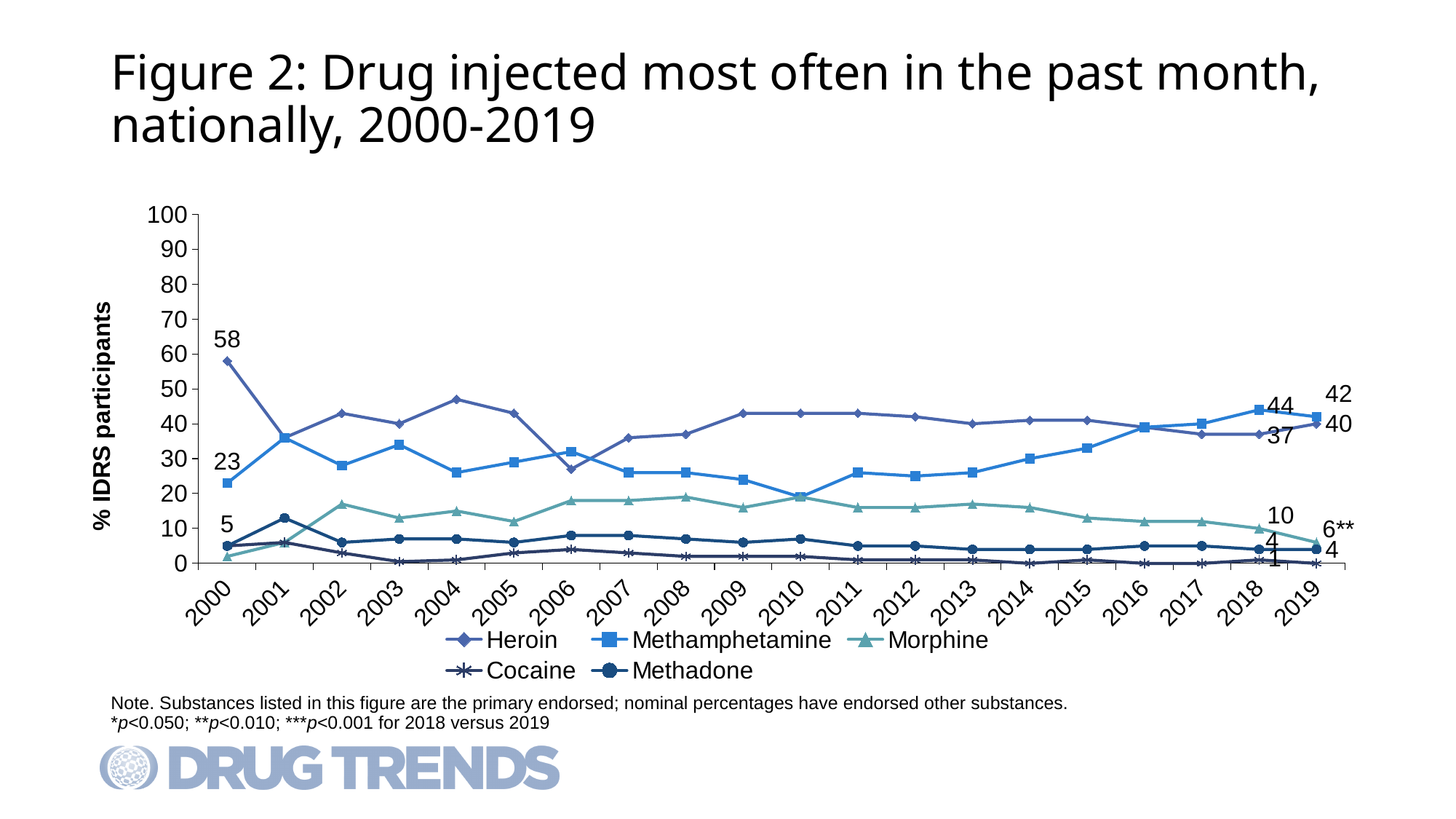
In 2019, which is larger: the value for Methamphetamine or the value for Heroin? Methamphetamine Which series has the highest value in 2000? Heroin What is the value for Methamphetamine in 2018? 44 What is the value for Methamphetamine in 2000? 23 How many series does the legend list? 5 Is the value for Morphine in 2010 greater or less than 10? greater What is the difference between the Heroin and Methamphetamine values in 2000? 35 What is the value for Heroin in 2000? 58 What is the value for Morphine in 2018? 10 Does the Methamphetamine line rise or fall between 2010 and 2018? rise How many years are plotted along the x axis? 20 What kind of chart is shown on the slide? line chart